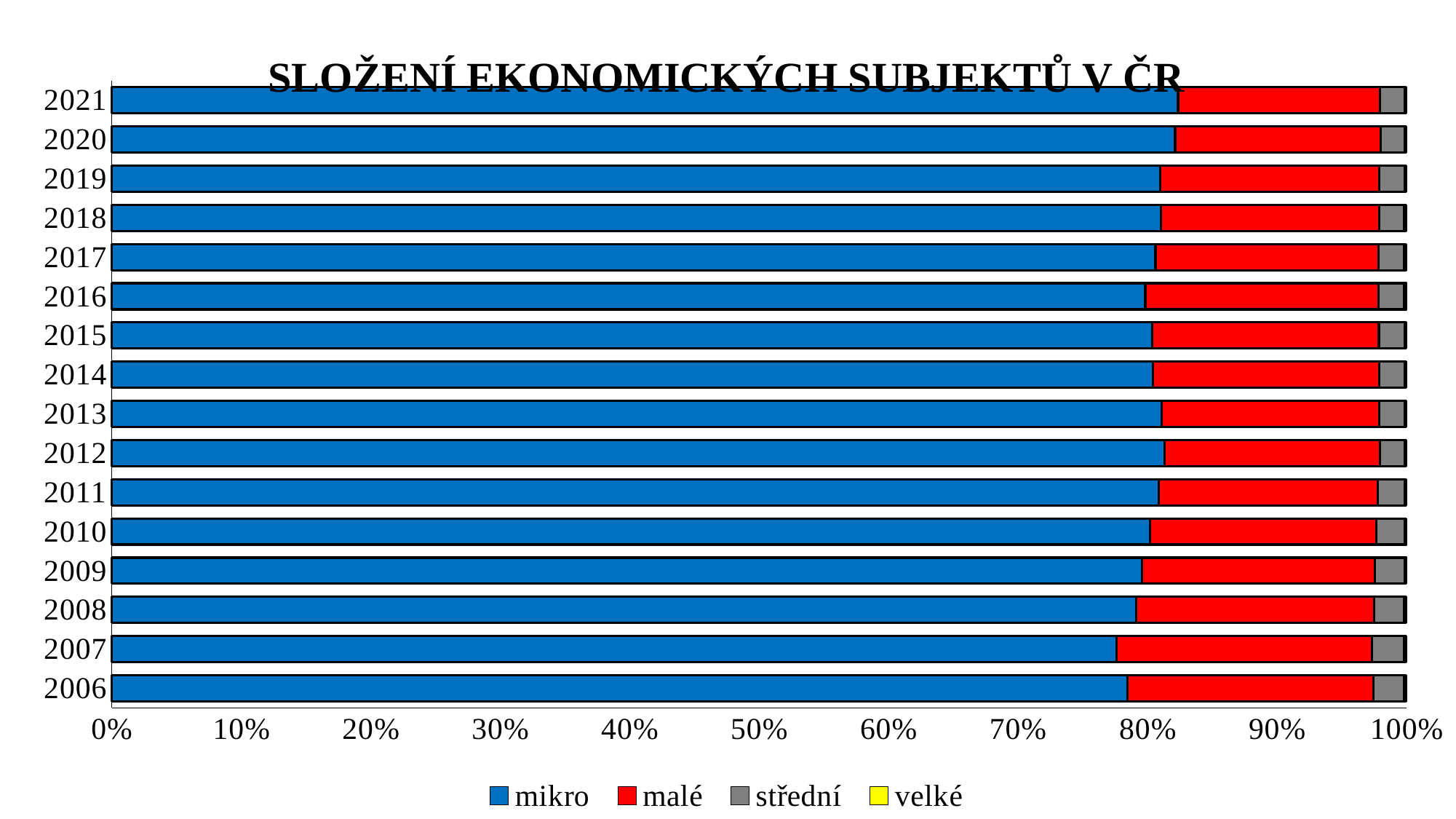
Which year has the larger 'malé' share, 2007 or 2021? 2007 Is the 'mikro' share for 2020 greater or less than 80%? greater Is the 'mikro' share for 2007 greater or less than 80%? less How many years (categories) are shown on the chart? 16 Is the 'mikro' share for 2006 greater or less than 80%? less Does the 'mikro' share generally rise or fall from 2006 to 2021? rise What kind of chart is shown on the slide? stacked bar chart Which colour represents the 'mikro' series in the chart? blue How many series does the legend list? 4 What is the title of the chart? SLOŽENÍ EKONOMICKÝCH SUBJEKTŮ V ČR Which year has the larger 'mikro' share, 2021 or 2006? 2021